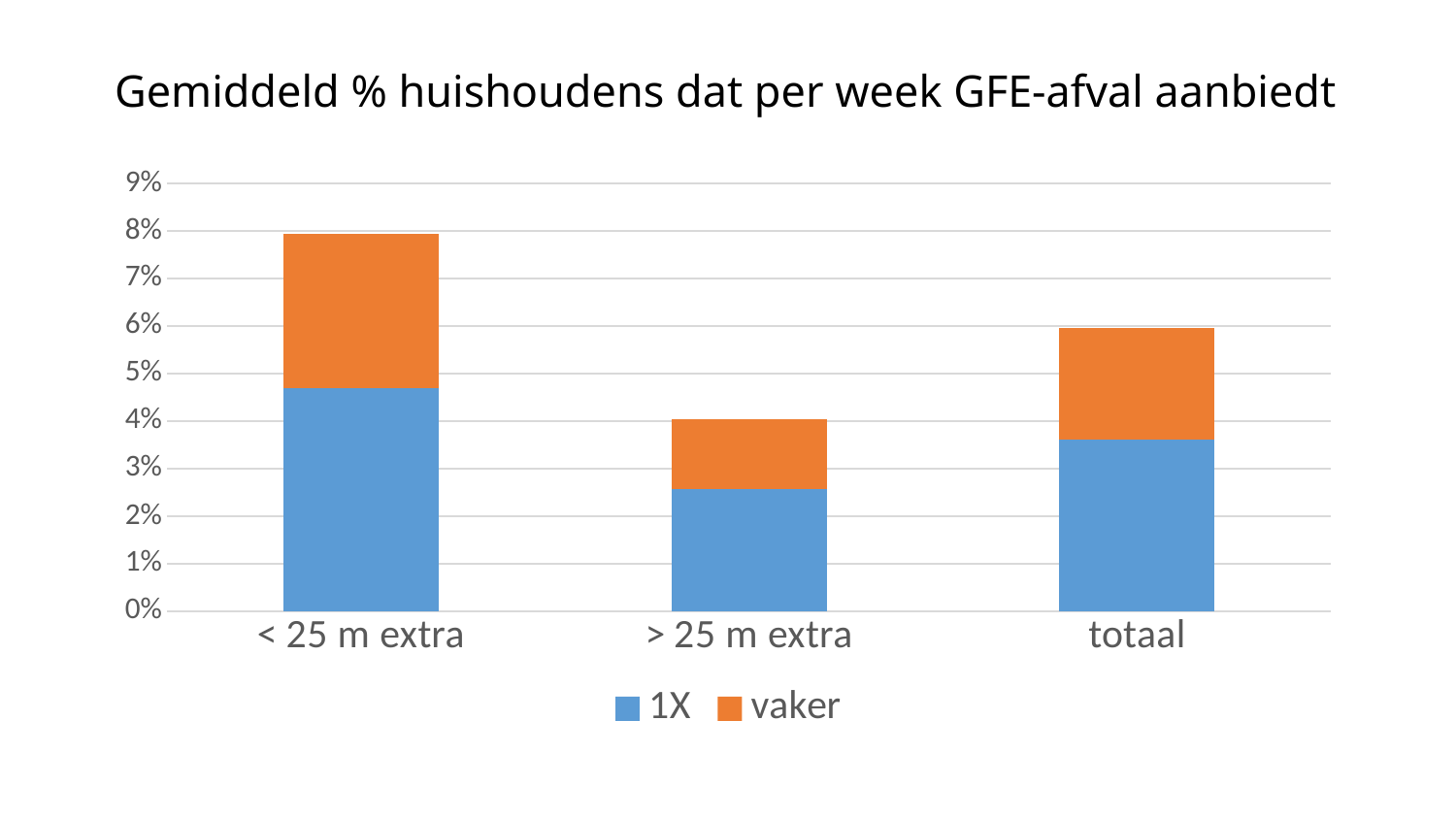
Is the total bar for totaal greater or less than 5%? greater What is the title of the chart? Gemiddeld % huishoudens dat per week GFE-afval aanbiedt Which category has the lowest total bar? > 25 m extra What kind of chart is shown on the slide? stacked bar chart How many categories are shown on the x axis? 3 Which category has the highest total bar? < 25 m extra Is the total bar for > 25 m extra greater or less than 5%? less Is the 1X value for > 25 m extra greater or less than 3%? less Which colour represents the series vaker in the chart? orange Which is larger, the 1X value for < 25 m extra or the 1X value for > 25 m extra? < 25 m extra How many series does the legend list? 2